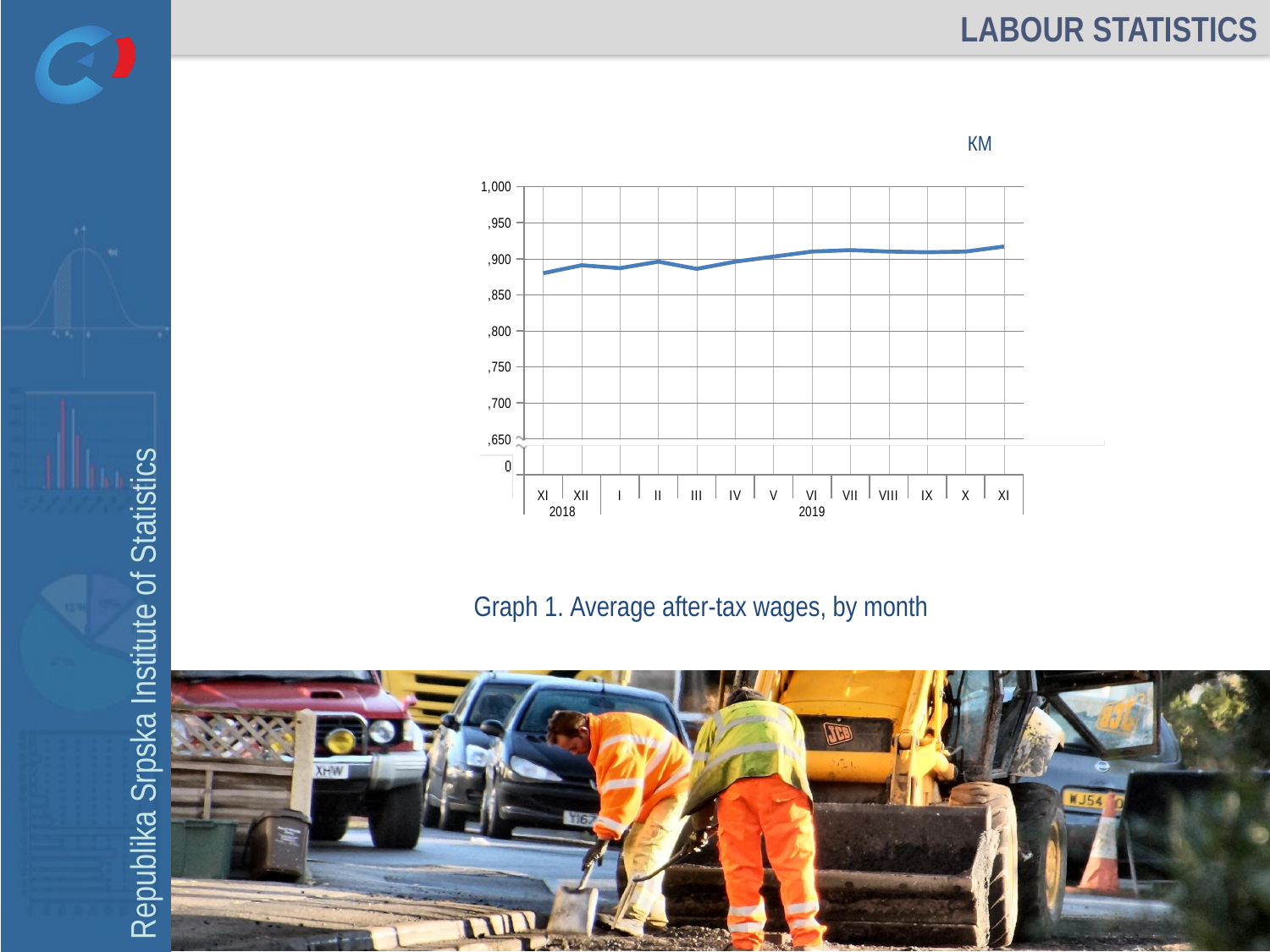
Which is larger, the value for II 2019 or the value for III 2019? II 2019 Do the average after-tax wages generally rise or fall from XI 2018 to XI 2019? rise Which is larger, the value for XI 2018 or the value for XI 2019? XI 2019 What kind of chart is shown on the slide? line chart Is the value for VII 2019 greater or less than 950? less What unit is indicated above the chart? KM Is the value for III 2019 greater or less than 900? less How many monthly data points are plotted on the chart? 13 Is the value for XI 2018 greater or less than 900? less What is the title of the chart on the slide? Graph 1. Average after-tax wages, by month